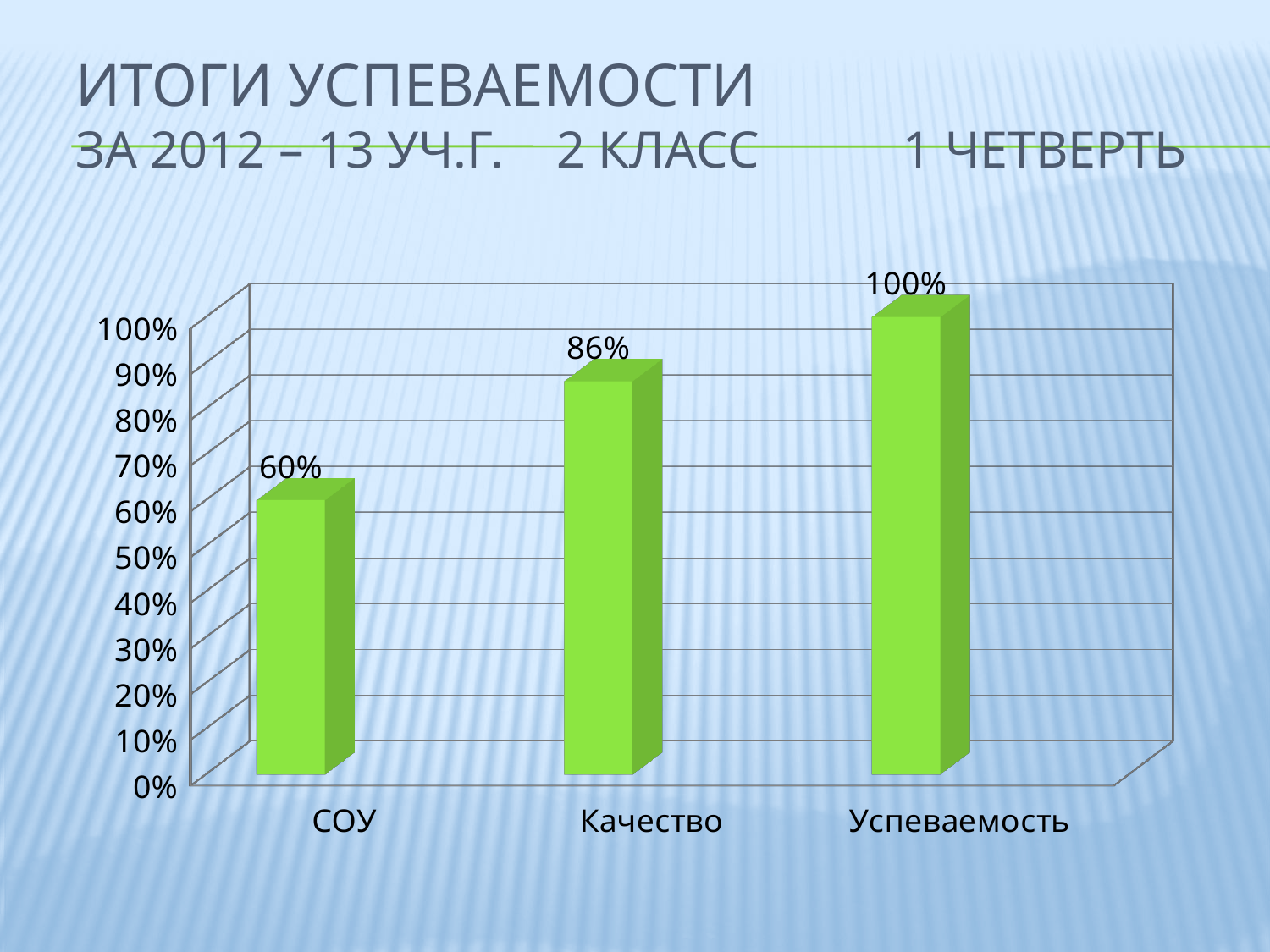
What is the value for СОУ? 60% Do the values rise or fall from left to right along the x axis? rise Which category has the highest value? Успеваемость What is the value for Качество? 86% What is the difference between the values for Успеваемость and Качество? 14% How many categories are shown on the x axis? 3 Which category has the lowest value? СОУ Is the value for Качество greater or less than 80%? greater Which is larger, the value for СОУ or the value for Качество? Качество What is the value for Успеваемость? 100% What is the difference between the values for Качество and СОУ? 26% What kind of chart is shown on the slide? bar chart